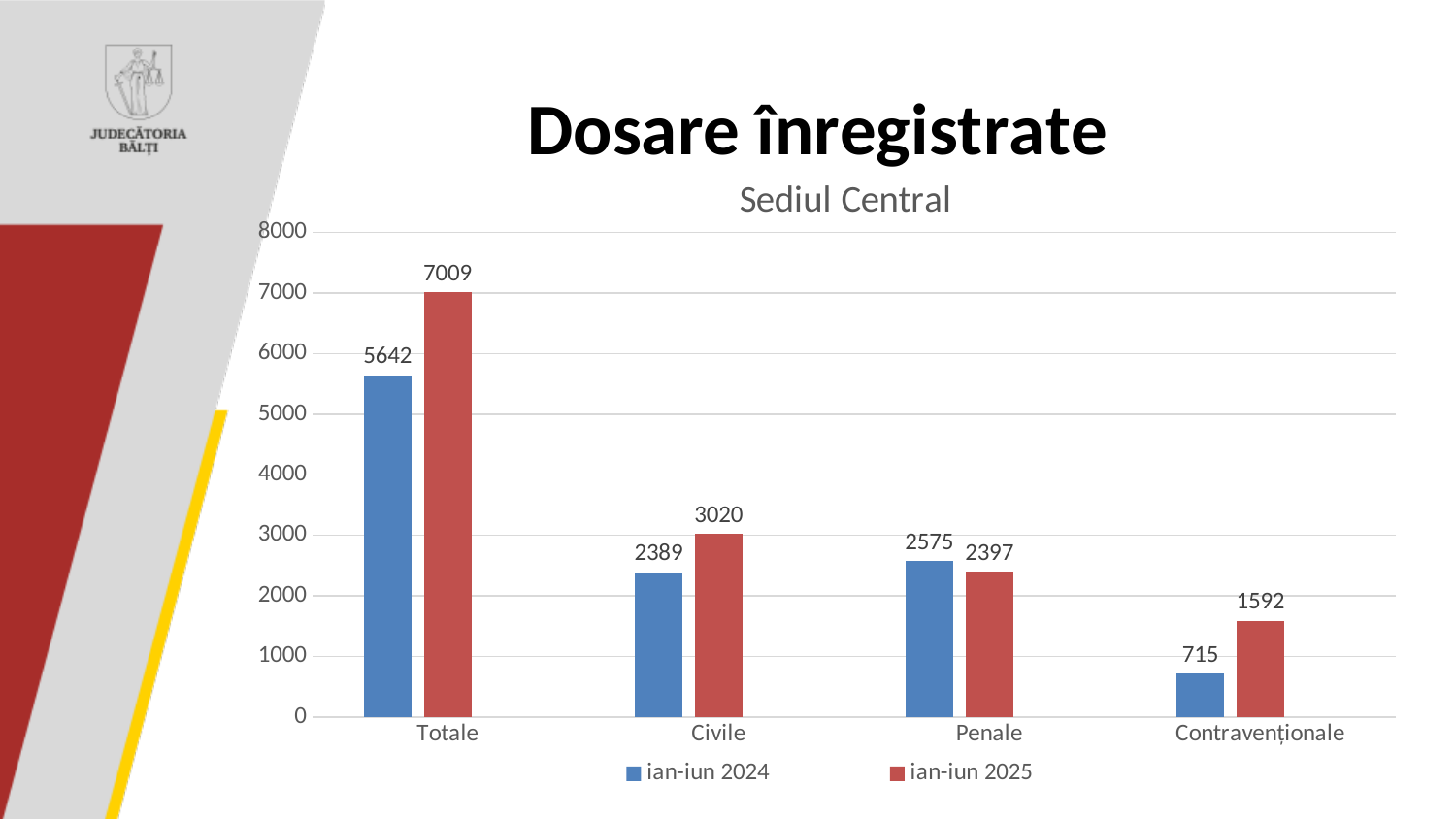
What is the difference between the ian-iun 2024 and ian-iun 2025 values for Penale? 178 What is the value for Civile in the ian-iun 2024 series? 2389 Which category has the highest value in the ian-iun 2025 series? Totale What is the difference between the ian-iun 2025 and ian-iun 2024 values for Totale? 1367 Which category has the lowest value in the ian-iun 2024 series? Contravenționale How many series does the legend list? 2 Which is larger for Penale: the ian-iun 2024 value or the ian-iun 2025 value? ian-iun 2024 What is the value for Totale in the ian-iun 2025 series? 7009 What is the value for Contravenționale in the ian-iun 2025 series? 1592 What is the subtitle shown above the chart? Sediul Central What kind of chart is shown on the slide? bar chart How many categories are shown on the x axis? 4